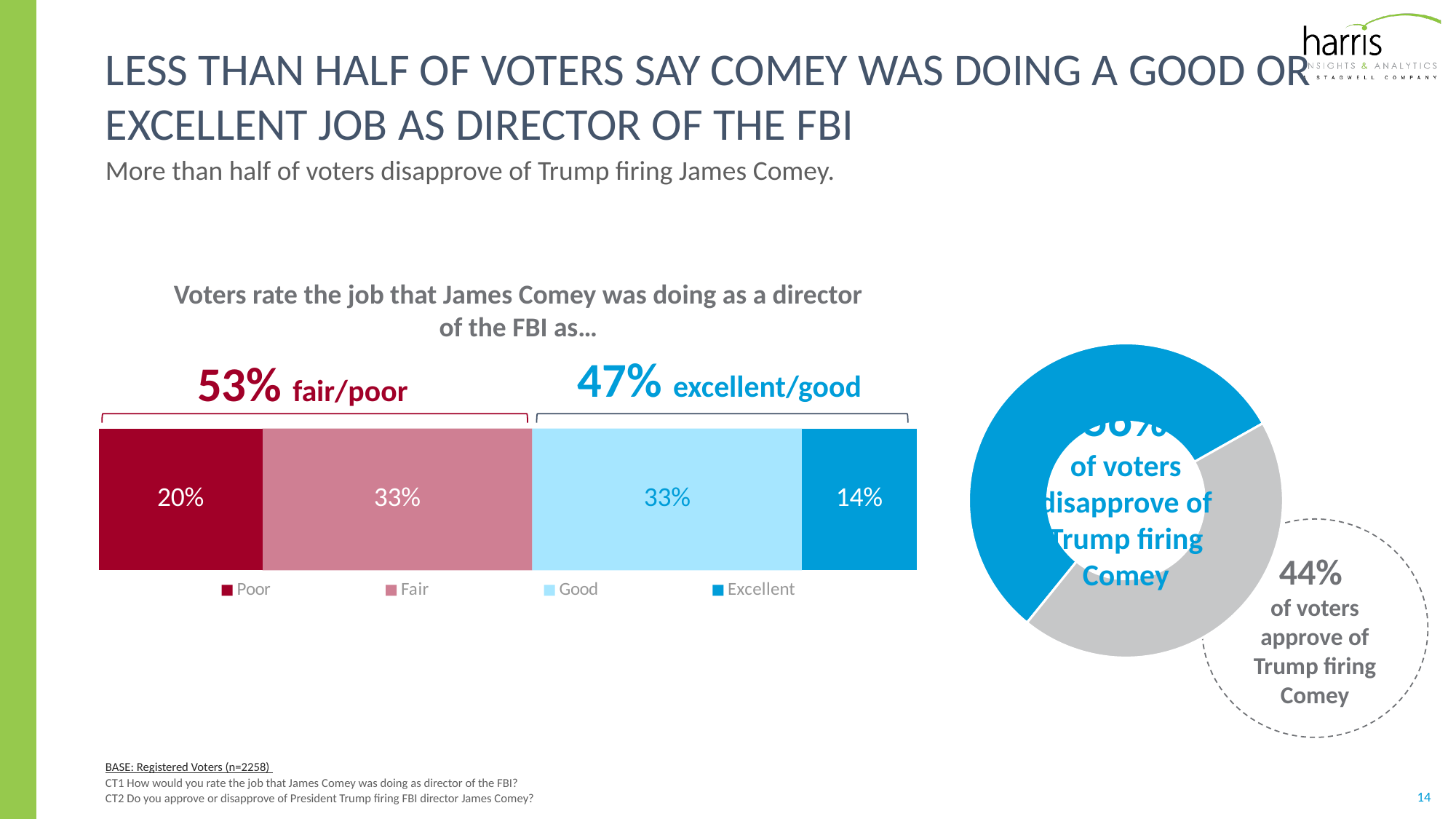
According to the bracket label above the stacked bar chart, what combined percentage of voters rate Comey's job as fair/poor? 53% According to the bracket label above the stacked bar chart, what combined percentage of voters rate Comey's job as excellent/good? 47% In the stacked bar chart on the left, what percentage of voters rate Comey's job as Fair? 33% In the stacked bar chart on the left, what percentage of voters rate Comey's job as Excellent? 14% In the stacked bar chart on the left, what percentage of voters rate Comey's job as Poor? 20% What type of chart is shown on the right of the slide? Donut chart In the stacked bar chart on the left, which rating category has the smallest share? Excellent What type of chart is shown on the left of the slide? Stacked bar chart In the stacked bar chart on the left, which is larger: the Poor share or the Excellent share? Poor In the donut chart on the right, what share of voters approve of Trump firing Comey? 44% How many series does the legend of the stacked bar chart on the left list? 4 In the stacked bar chart on the left, what is the difference between the Fair share and the Poor share? 13 percentage points